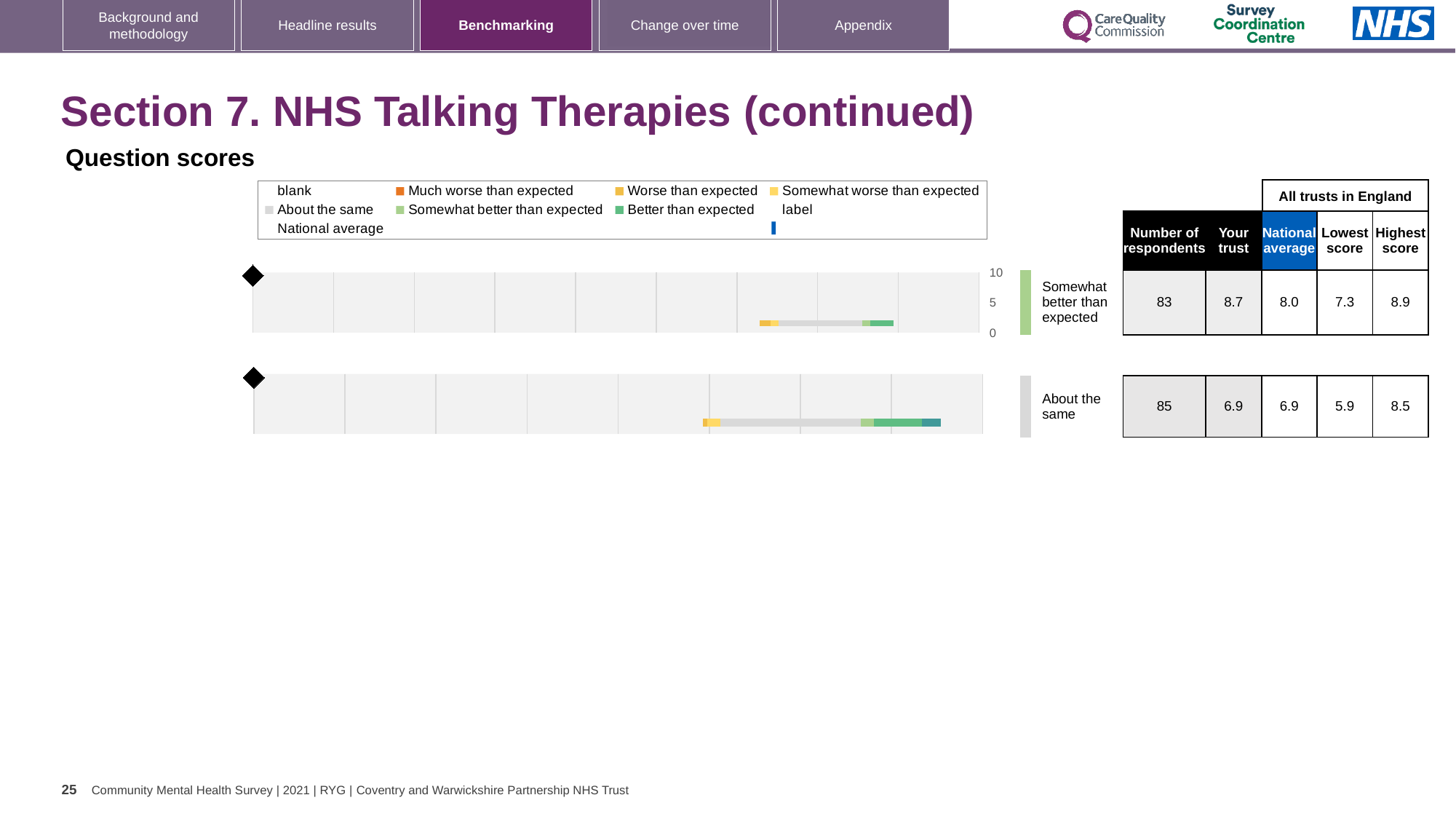
For the bottom chart (rated 'About the same'), what is the difference between the highest score and the lowest score among all trusts in England? 2.6 What kind of chart is used to show the question scores on this slide? bar chart For the top chart (rated 'Somewhat better than expected'), what is the difference between the 'Your trust' score and the national average? 0.7 In the table beside the top chart (rated 'Somewhat better than expected'), what is the 'Your trust' score? 8.7 In the table beside the bottom chart (rated 'About the same'), what is the lowest score among all trusts in England? 5.9 In the table beside the bottom chart (rated 'About the same'), how many respondents are listed? 85 How many question-score bar charts are shown on the slide? 2 For the top chart (rated 'Somewhat better than expected'), which is larger: the 'Your trust' score or the national average? Your trust What benchmark rating label is shown next to the top bar chart? Somewhat better than expected Which of the two charts has the higher 'Your trust' score, the top one or the bottom one? the top one In the table beside the top chart (rated 'Somewhat better than expected'), what is the national average score? 8.0 What is the highest value shown on the axis of the top bar chart? 10